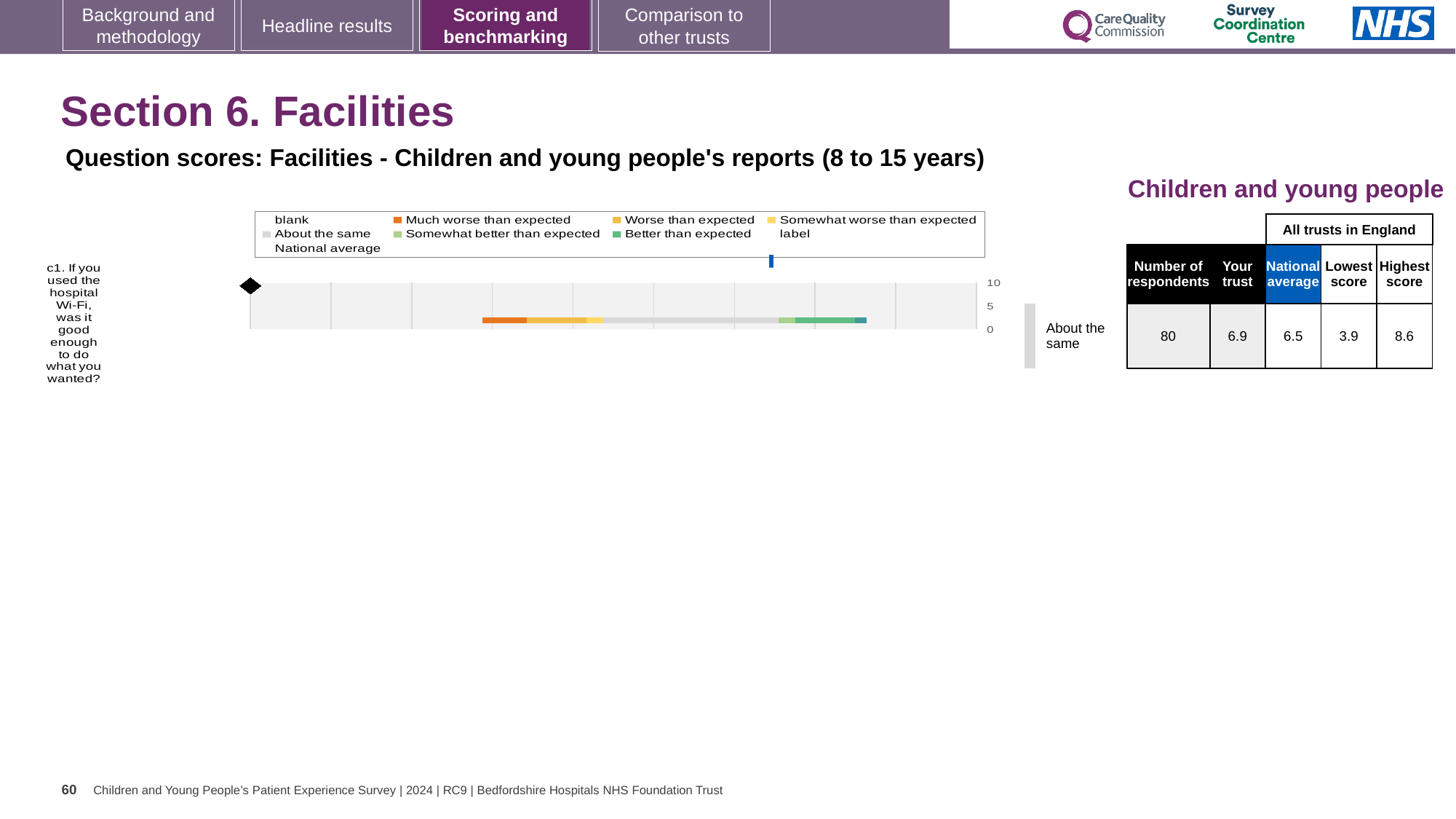
According to the table beside the chart, what is the 'Your trust' score for question c1? 6.9 Which question is plotted in the chart? c1. If you used the hospital Wi-Fi, was it good enough to do what you wanted? According to the table beside the chart, what is the highest score among all trusts in England for question c1? 8.6 What is the title of the table beside the chart? Children and young people According to the table beside the chart, how many respondents answered question c1? 80 Is the trust's score for question c1 higher or lower than the national average? Higher How many questions (categories) are plotted in the chart? 1 What is the difference between the highest and lowest scores for question c1 in the table beside the chart? 4.7 What benchmark category is shown next to the chart for question c1? About the same According to the table beside the chart, what is the national average score for question c1? 6.5 What kind of chart is shown on the slide? Bar chart According to the table beside the chart, what is the lowest score among all trusts in England for question c1? 3.9